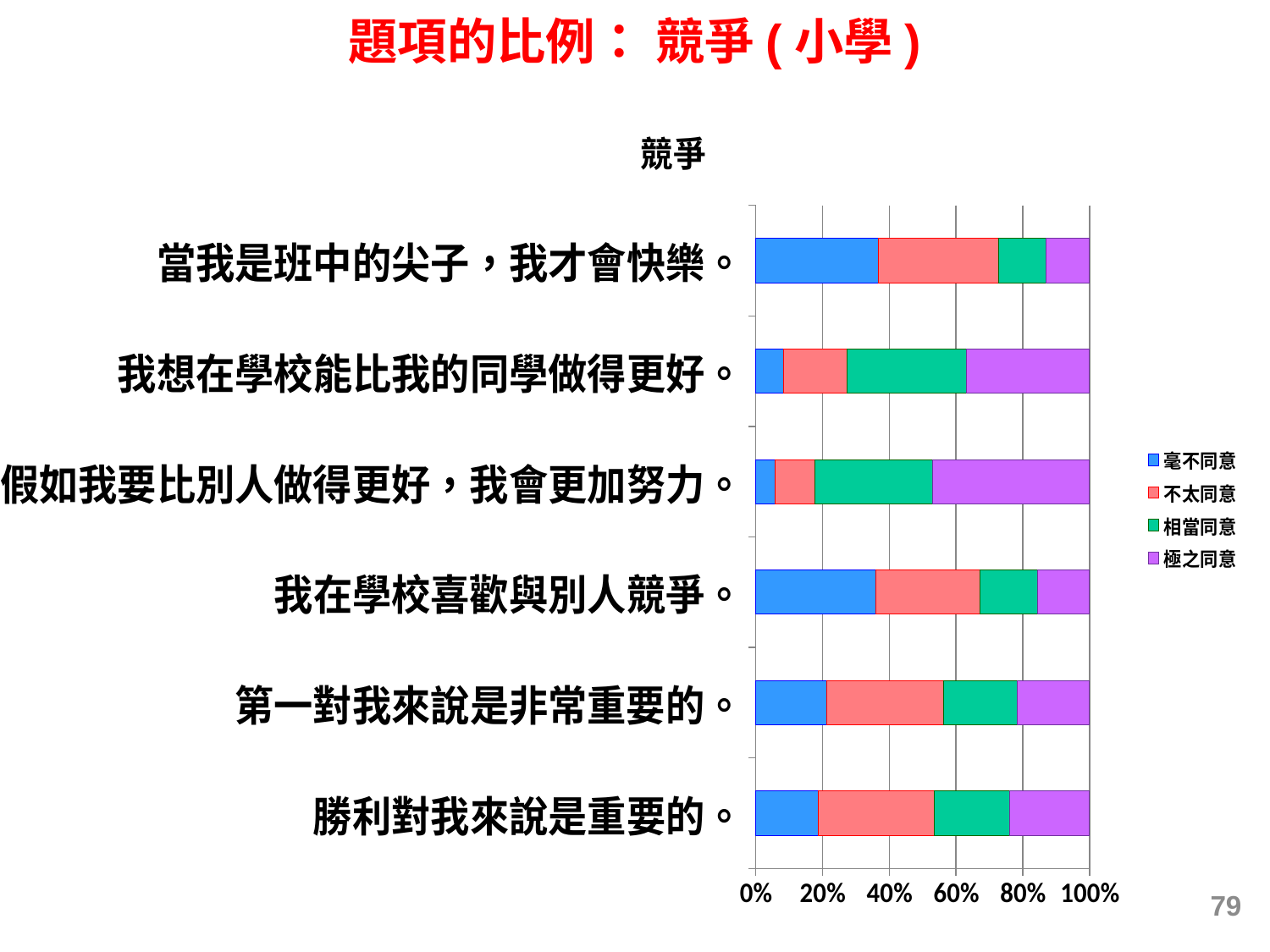
How many series does the legend list? 4 Which statement has the largest 極之同意 share? 假如我要比別人做得更好，我會更加努力。 What kind of chart is shown on the slide? Stacked bar chart What is the title of the chart? 競爭 Which legend entry is shown in purple? 極之同意 Is the 極之同意 share for 「當我是班中的尖子，我才會快樂。」 greater or less than 20%? less Is the 毫不同意 share for 「當我是班中的尖子，我才會快樂。」 greater or less than 20%? greater Which has the larger 毫不同意 share: 「當我是班中的尖子，我才會快樂。」 or 「我想在學校能比我的同學做得更好。」? 當我是班中的尖子，我才會快樂。 How many statements (categories) are plotted in the chart? 6 Is the 毫不同意 share for 「假如我要比別人做得更好，我會更加努力。」 greater or less than 20%? less Which has the larger 極之同意 share: 「我想在學校能比我的同學做得更好。」 or 「當我是班中的尖子，我才會快樂。」? 我想在學校能比我的同學做得更好。